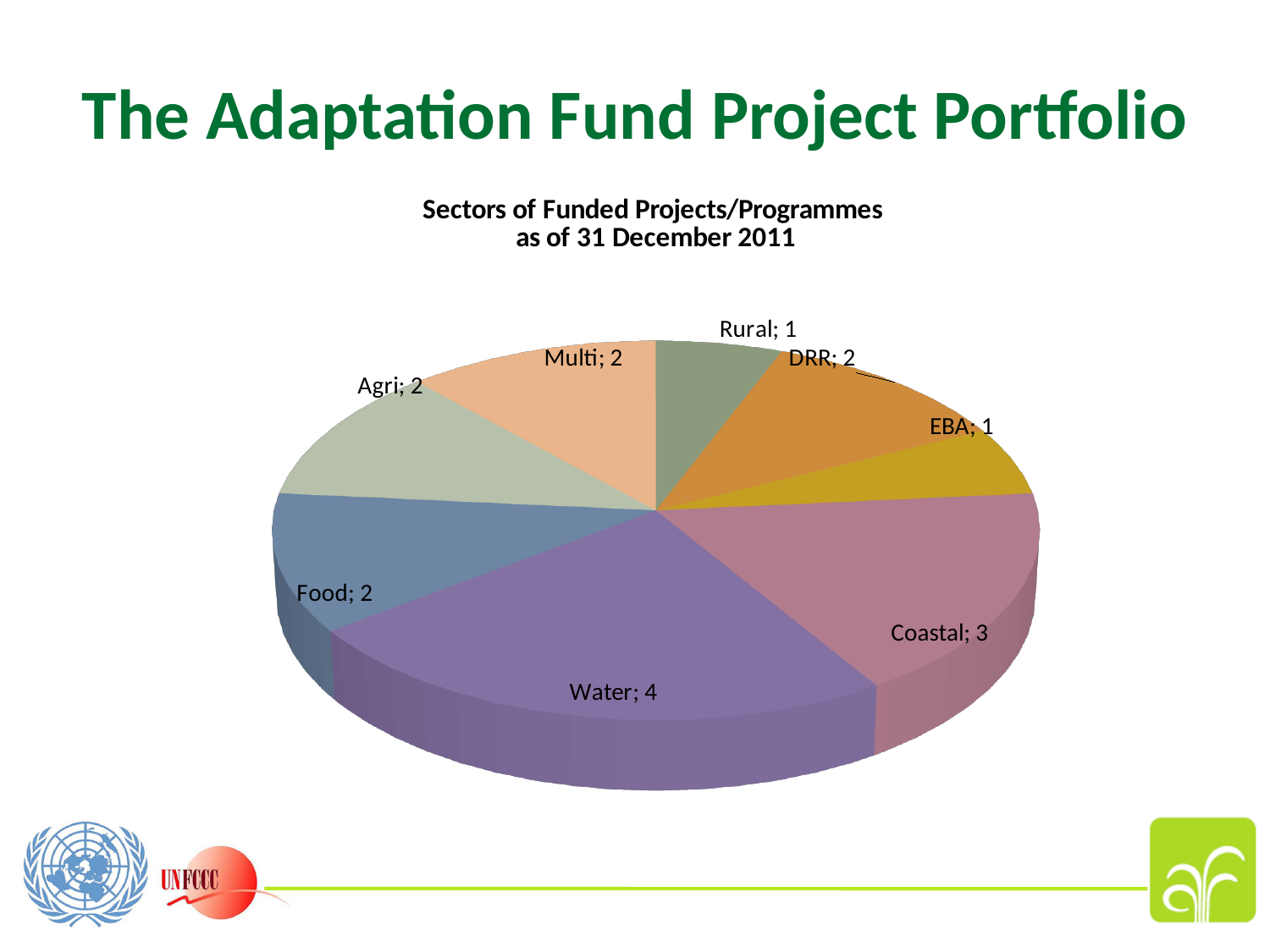
How many sectors (slices) are shown in the pie chart? 8 What is the value for the Water sector? 4 Which sector has the largest slice of the pie? Water What is the difference between the values for Water and Coastal? 1 Which is larger, the value for Coastal or the value for Food? Coastal Which sectors have the smallest value in the pie chart? Rural and EBA What type of chart is shown on the slide? Pie chart What is the total of all the values shown in the pie chart? 17 What is the title of the chart? Sectors of Funded Projects/Programmes as of 31 December 2011 What is the value for the Coastal sector? 3 What is the value for the EBA sector? 1 What fraction of the total does the Water slice represent? 4 out of 17